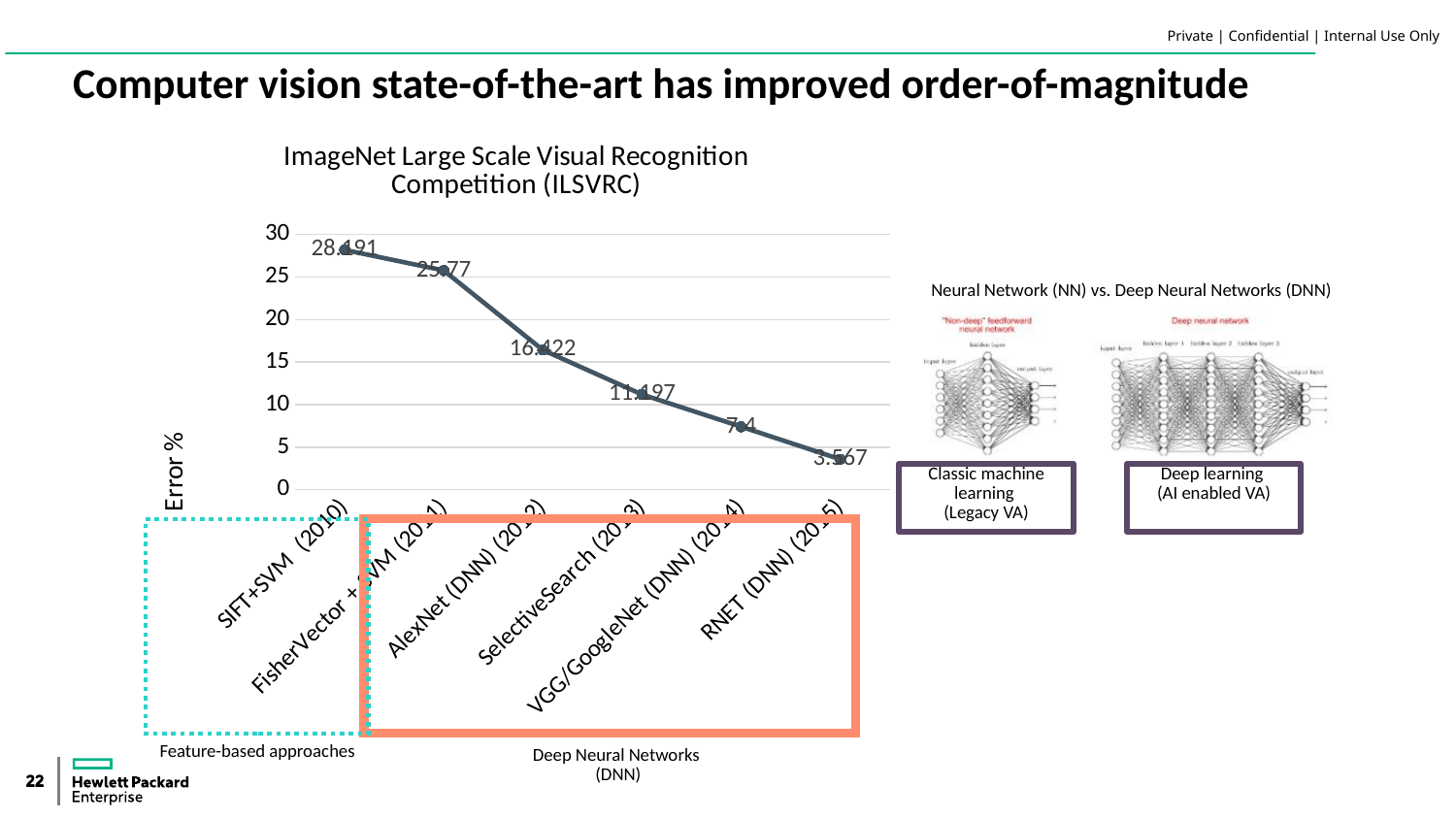
What is the error % for SIFT+SVM (2010)? 28.191 What is the error % for SelectiveSearch (2013)? 11.197 Is the error % for VGG/GoogleNet (DNN) (2014) greater or less than 10? less What type of chart is shown on the slide? line chart Which category has the lowest error %? RNET (DNN) (2015) Which category has the highest error %? SIFT+SVM (2010) What is the title of the chart? ImageNet Large Scale Visual Recognition Competition (ILSVRC) Do the error % values rise or fall along the x axis from 2010 to 2015? fall What is the error % for RNET (DNN) (2015)? 3.567 What is the error % for AlexNet (DNN) (2012)? 16.422 What is the error % for FisherVector + SVM (2011)? 25.77 What is the difference in error % between FisherVector + SVM (2011) and AlexNet (DNN) (2012)? 9.348